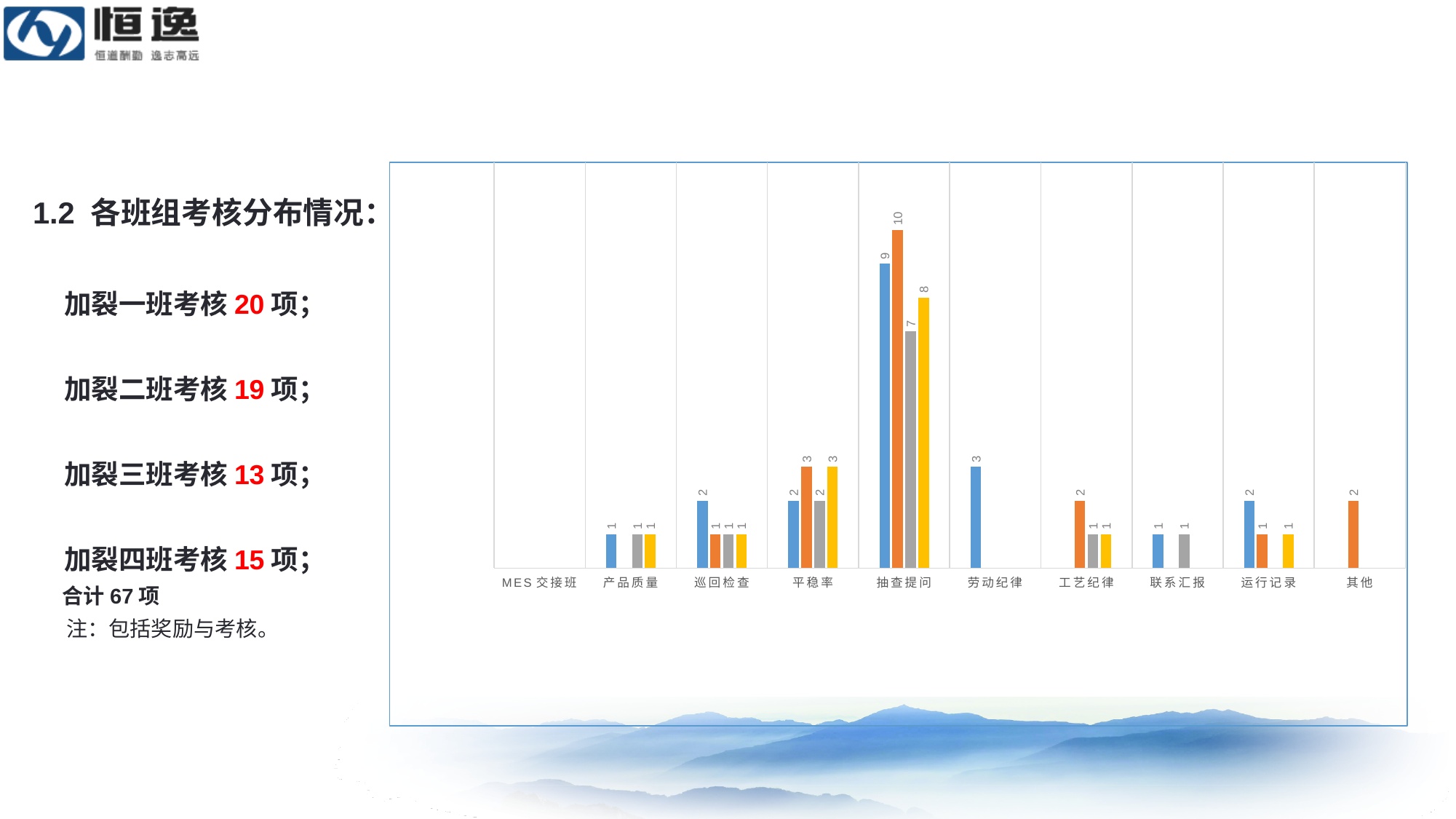
What kind of chart is shown on the slide? bar chart Which is larger for 平稳率: the orange bar or the blue bar? the orange bar Which category has the tallest bar in the chart? 抽查提问 What is the value of the orange bar for 其他? 2 How many categories are shown on the x axis of the chart? 10 What is the value of the blue bar for 劳动纪律? 3 What is the value of the grey bar for 抽查提问? 7 What is the total of the four bars for 抽查提问? 34 What is the value of the blue bar for 抽查提问? 9 What is the value of the orange bar for 抽查提问? 10 Which category on the x axis has no bars plotted? MES交接班 What is the difference between the orange bar and the grey bar for 抽查提问? 3